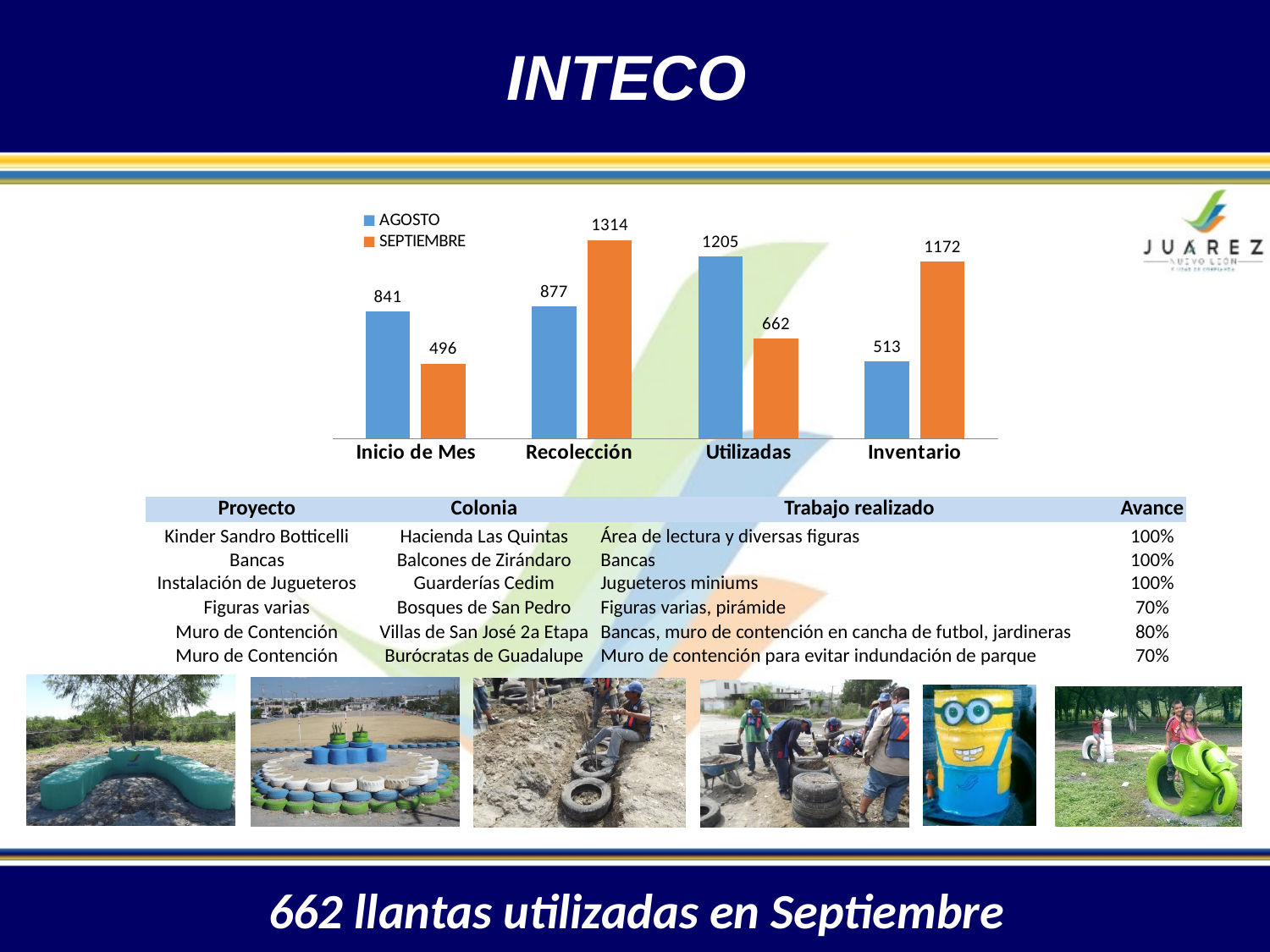
What is the SEPTIEMBRE value for Recolección? 1314 Which category has the highest AGOSTO value? Utilizadas What type of chart is shown on the slide? bar chart What is the difference between the SEPTIEMBRE and AGOSTO values for Inventario? 659 Which colour represents the SEPTIEMBRE series in the chart? orange What is the AGOSTO value for Inicio de Mes? 841 How many series does the chart legend list? 2 What is the SEPTIEMBRE value for Utilizadas? 662 What is the AGOSTO value for Inventario? 513 How many categories are shown on the x axis of the chart? 4 For Utilizadas, which series has the larger value, AGOSTO or SEPTIEMBRE? AGOSTO Which category has the lowest SEPTIEMBRE value? Inicio de Mes